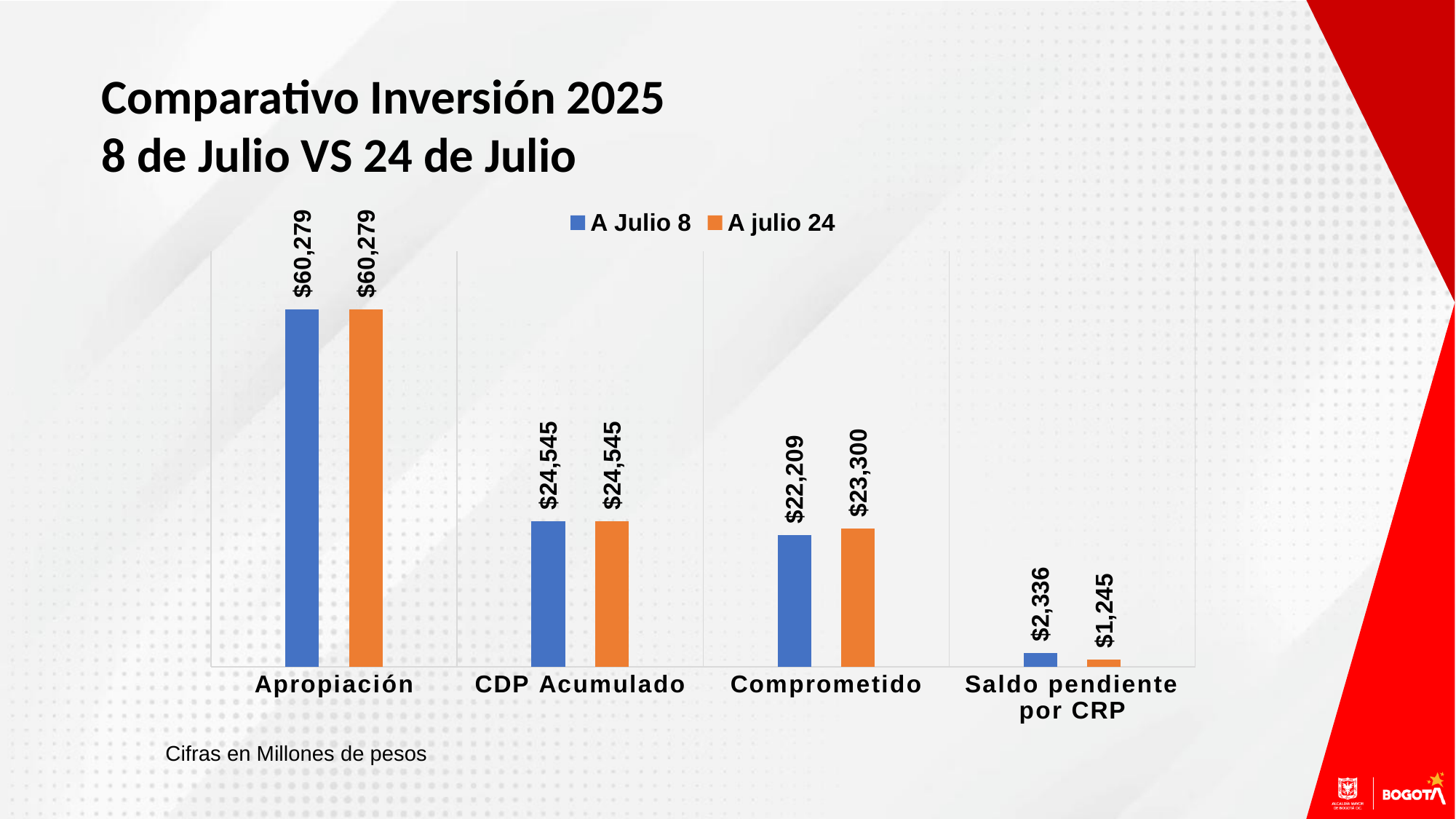
For Saldo pendiente por CRP, which series has the larger value, A Julio 8 or A julio 24? A Julio 8 How many series does the legend list? 2 What kind of chart is shown on the slide? Bar chart What is the value for Comprometido in the A julio 24 series? $23,300 What is the value for Apropiación in the A Julio 8 series? $60,279 Which category has the lowest value in the A Julio 8 series? Saldo pendiente por CRP What is the value for Saldo pendiente por CRP in the A Julio 8 series? $2,336 What is the difference between the A Julio 8 and A julio 24 values for Saldo pendiente por CRP? $1,091 Which category has the highest value in the A julio 24 series? Apropiación How many categories are shown on the x axis? 4 What is the difference between the A julio 24 and A Julio 8 values for Comprometido? $1,091 What is the value for CDP Acumulado in the A julio 24 series? $24,545